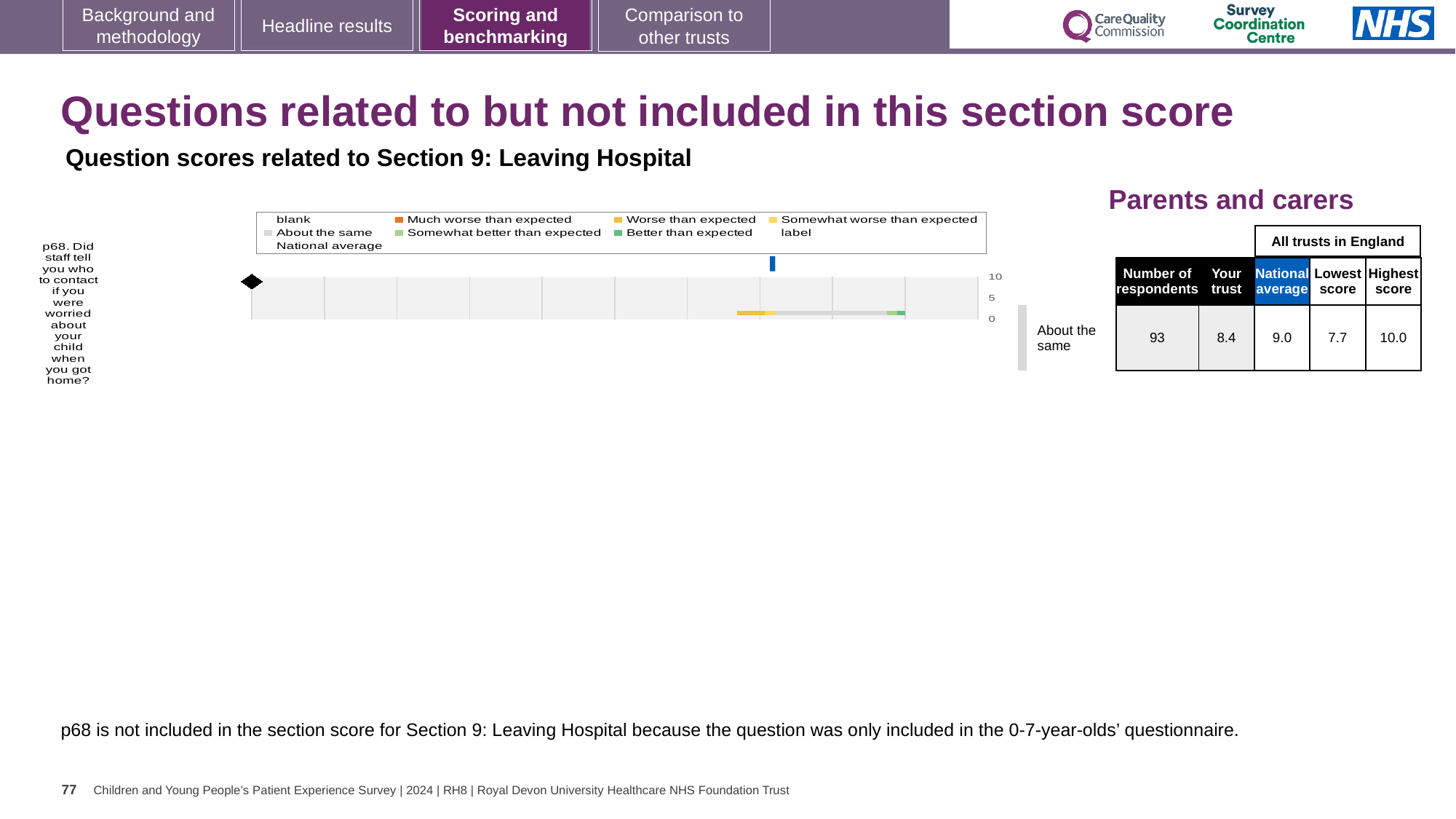
Which legend entry is shown in orange? Much worse than expected What kind of chart is shown on the slide for question p68? bar chart What is the highest value shown on the chart's numeric axis? 10 According to the table beside the chart, how many respondents answered p68? 93 For p68, what is the difference between the national average (9.0) and the 'Your trust' score (8.4)? 0.6 How many survey questions are plotted in the chart? 1 According to the table beside the chart, what is the lowest score among all trusts in England for p68? 7.7 According to the table beside the chart, what is the 'Your trust' score for p68? 8.4 According to the table beside the chart, what is the national average score for p68? 9.0 According to the table beside the chart, what is the highest score among all trusts in England for p68? 10.0 For p68, which is larger: the 'Your trust' score or the national average? National average What benchmark category is shown for question p68 next to the chart? About the same